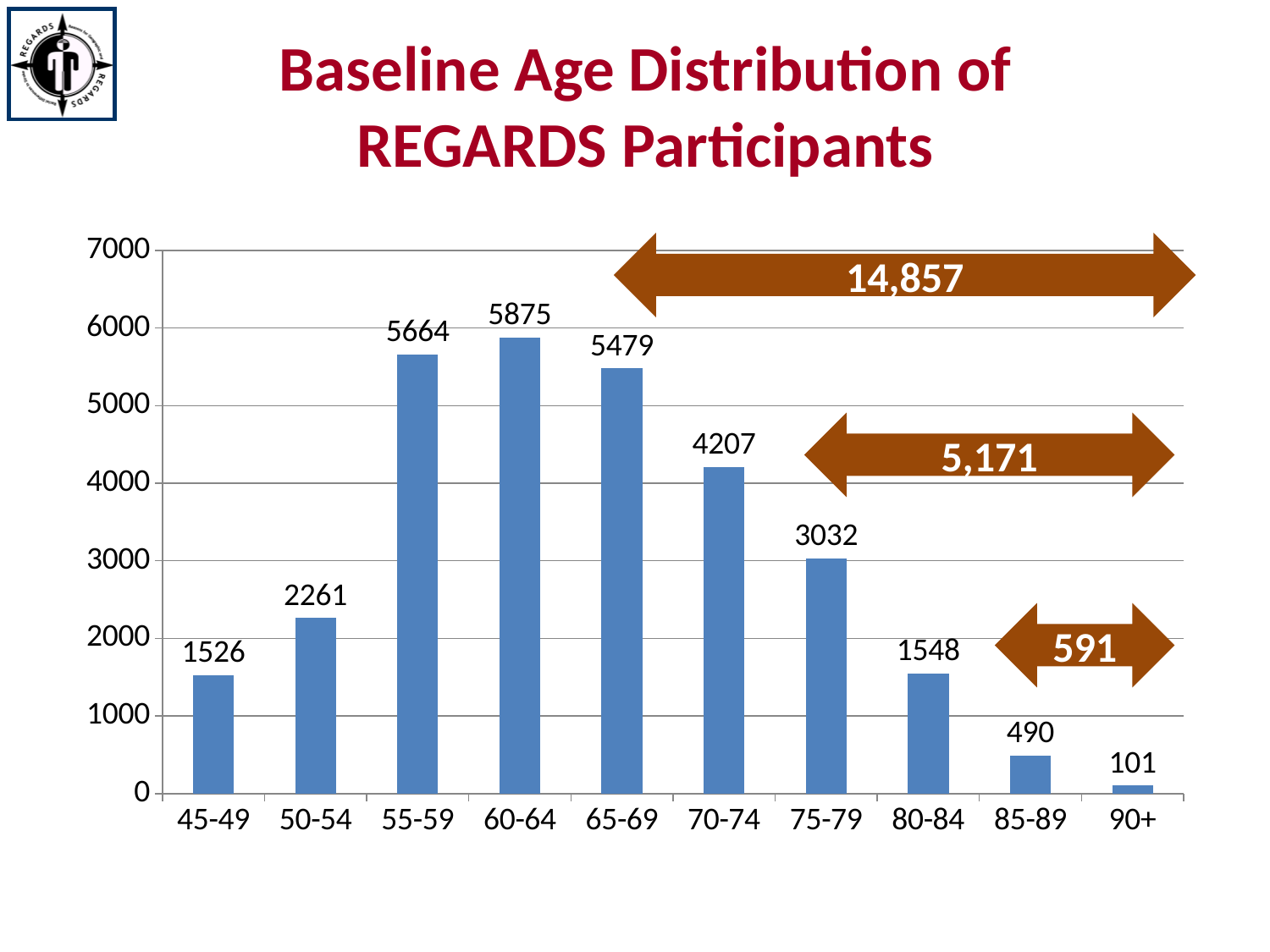
What is the difference between the 70-74 and 75-79 age groups? 1175 What number is shown in the arrow spanning the 65-69 to 90+ age groups? 14,857 What is the title of the chart? Baseline Age Distribution of REGARDS Participants Which age group has the lowest number of participants? 90+ What is the value for the 45-49 age group? 1526 What is the number of participants in the 85-89 age group? 490 What kind of chart is shown on the slide? Bar chart How many age groups are shown on the x axis? 10 Which has more participants, the 50-54 group or the 80-84 group? 50-54 Which age group has the highest number of participants? 60-64 Do the values rise or fall from the 65-69 group to the 90+ group? Fall What is the number of participants in the 60-64 age group? 5875